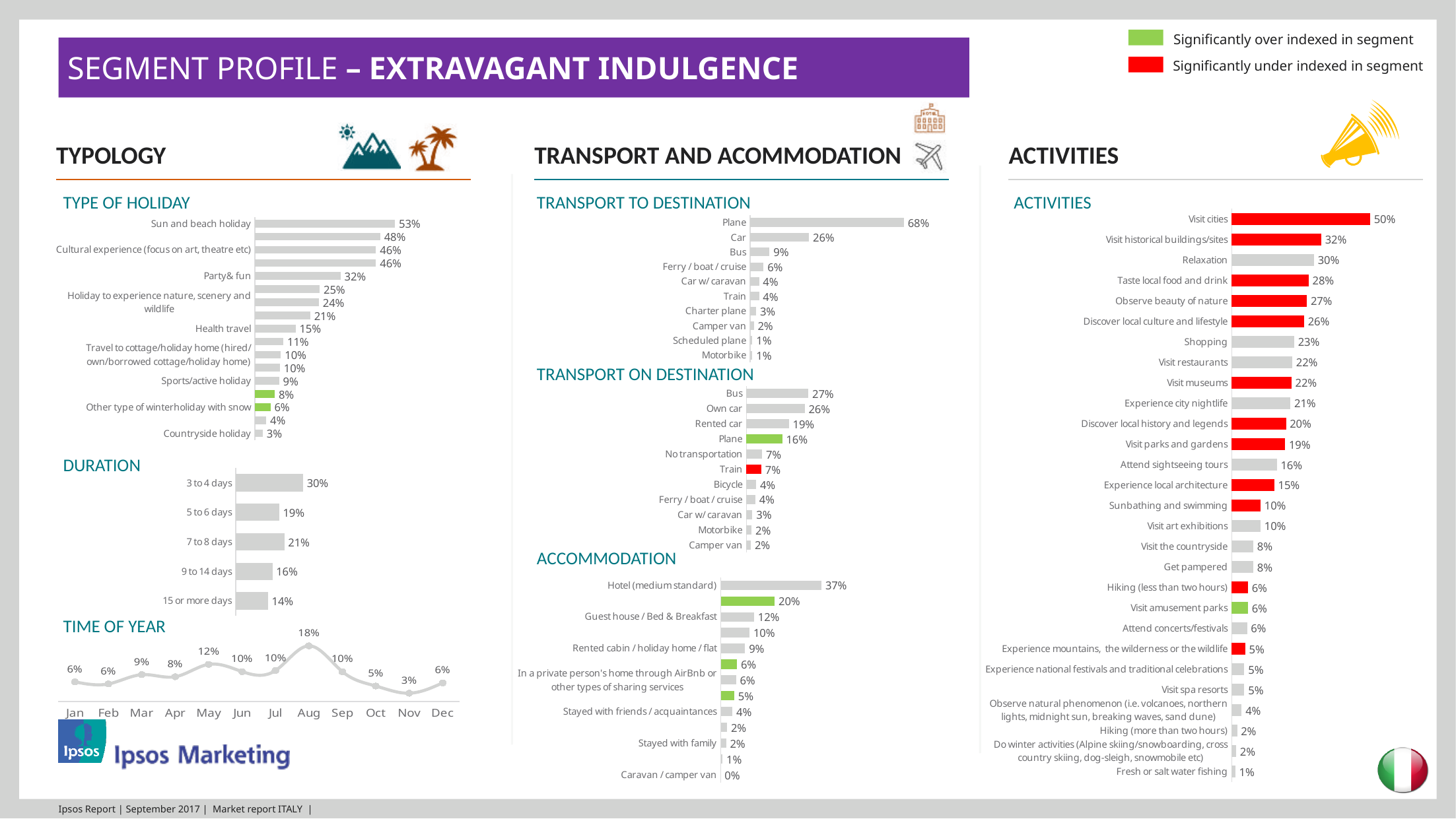
In the Transport to Destination chart, what is the value for Plane? 68% What kind of chart is the Time of Year chart? Line chart In the Accommodation chart, what is the value for Hotel (medium standard)? 37% In the Duration chart, what is the difference between 7 to 8 days and 5 to 6 days? 2% In the Type of Holiday chart, what is the value for Sun and beach holiday? 53% In the Activities chart, which category has the lowest value? Fresh or salt water fishing In the Activities chart, what is the value for Shopping? 23% How many categories are shown in the Transport to Destination chart? 10 In the Transport on Destination chart, which is larger, Bus or Rented car? Bus In the Time of Year chart, what is the value for Nov? 3% In the Duration chart, which category has the highest value? 3 to 4 days In the Time of Year chart, which month has the highest value? Aug